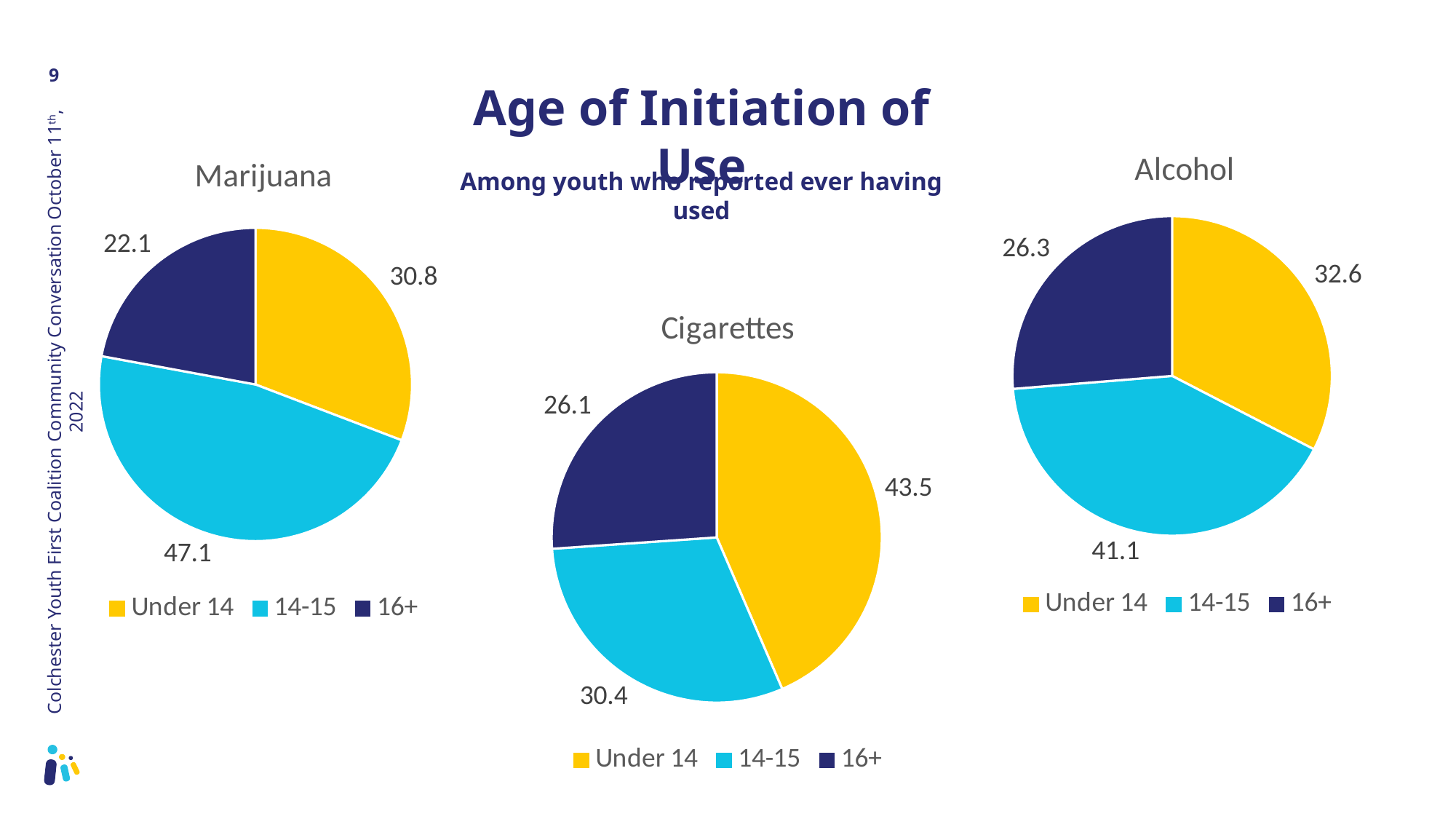
In the Alcohol chart, what is the value for the 16+ slice? 26.3 In the Marijuana chart, what is the difference between the 14-15 value and the Under 14 value? 16.3 In the Cigarettes chart, which age group has the smallest slice? 16+ In the Alcohol chart, which age group has the largest slice? 14-15 How many slices does the Cigarettes chart have? 3 Which is larger: the Under 14 value in the Alcohol chart or the Under 14 value in the Marijuana chart? Alcohol How many entries does the legend of the Marijuana chart list? 3 In the Cigarettes chart, what is the value for the Under 14 slice? 43.5 In the Marijuana chart, which age group has the largest slice? 14-15 In the Marijuana chart, what is the value for the 14-15 slice? 47.1 In the Cigarettes chart, what is the difference between the Under 14 value and the 14-15 value? 13.1 What kind of chart is the Alcohol chart? Pie chart